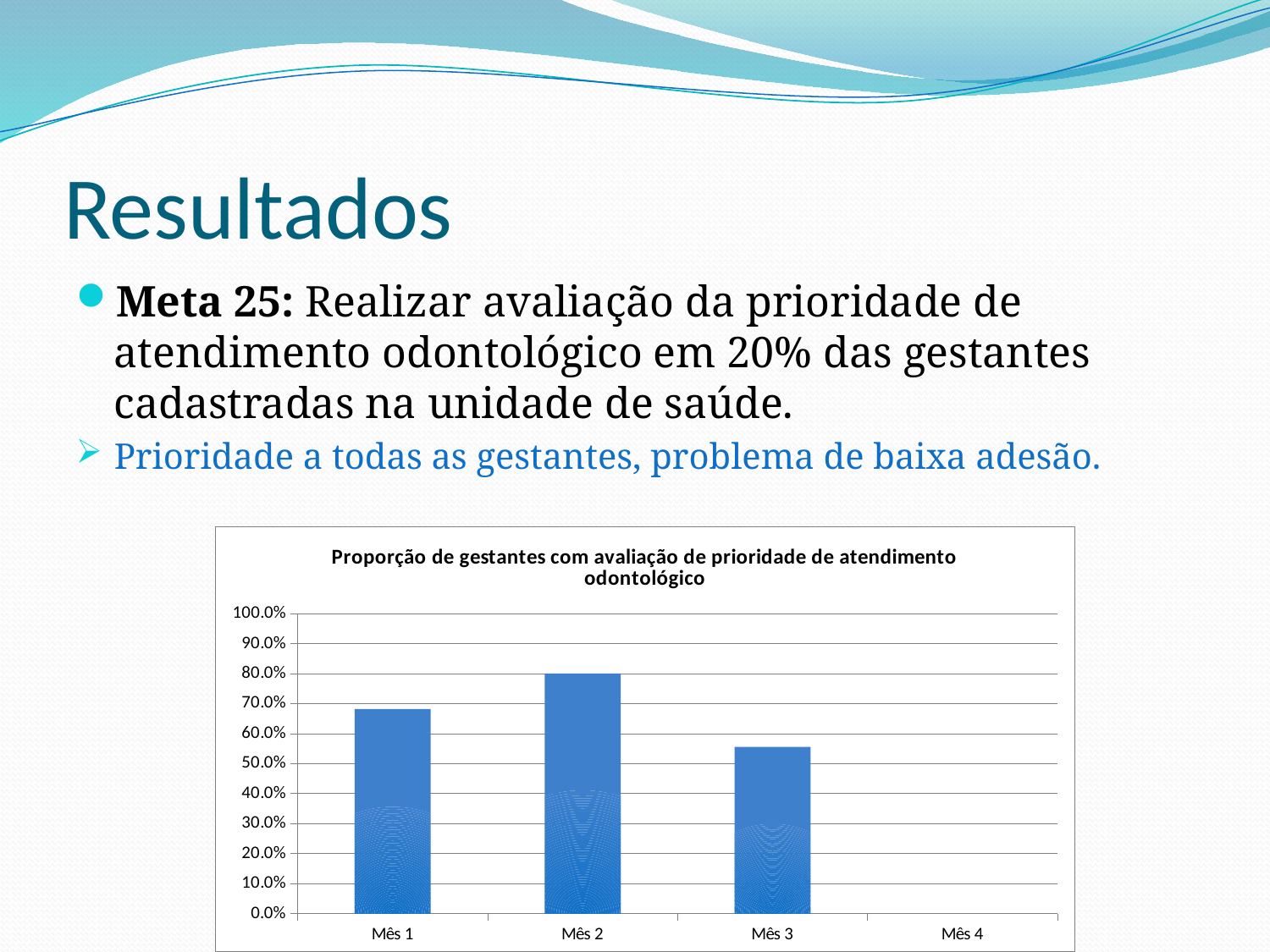
What kind of chart is shown on the slide? bar chart How many categories are shown on the x axis of the chart? 4 Does the value rise or fall from Mês 2 to Mês 3? fall Is the value for Mês 3 greater or less than 50.0%? greater Which is larger, the value for Mês 1 or the value for Mês 3? Mês 1 Is the value for Mês 3 greater or less than 60.0%? less Which month has the highest value in the chart? Mês 2 What is the value for Mês 2? 80.0% Which is larger, the value for Mês 1 or the value for Mês 2? Mês 2 Is the value for Mês 1 greater or less than 60.0%? greater What is the title of the chart? Proporção de gestantes com avaliação de prioridade de atendimento odontológico What is the highest value shown on the y axis of the chart? 100.0%